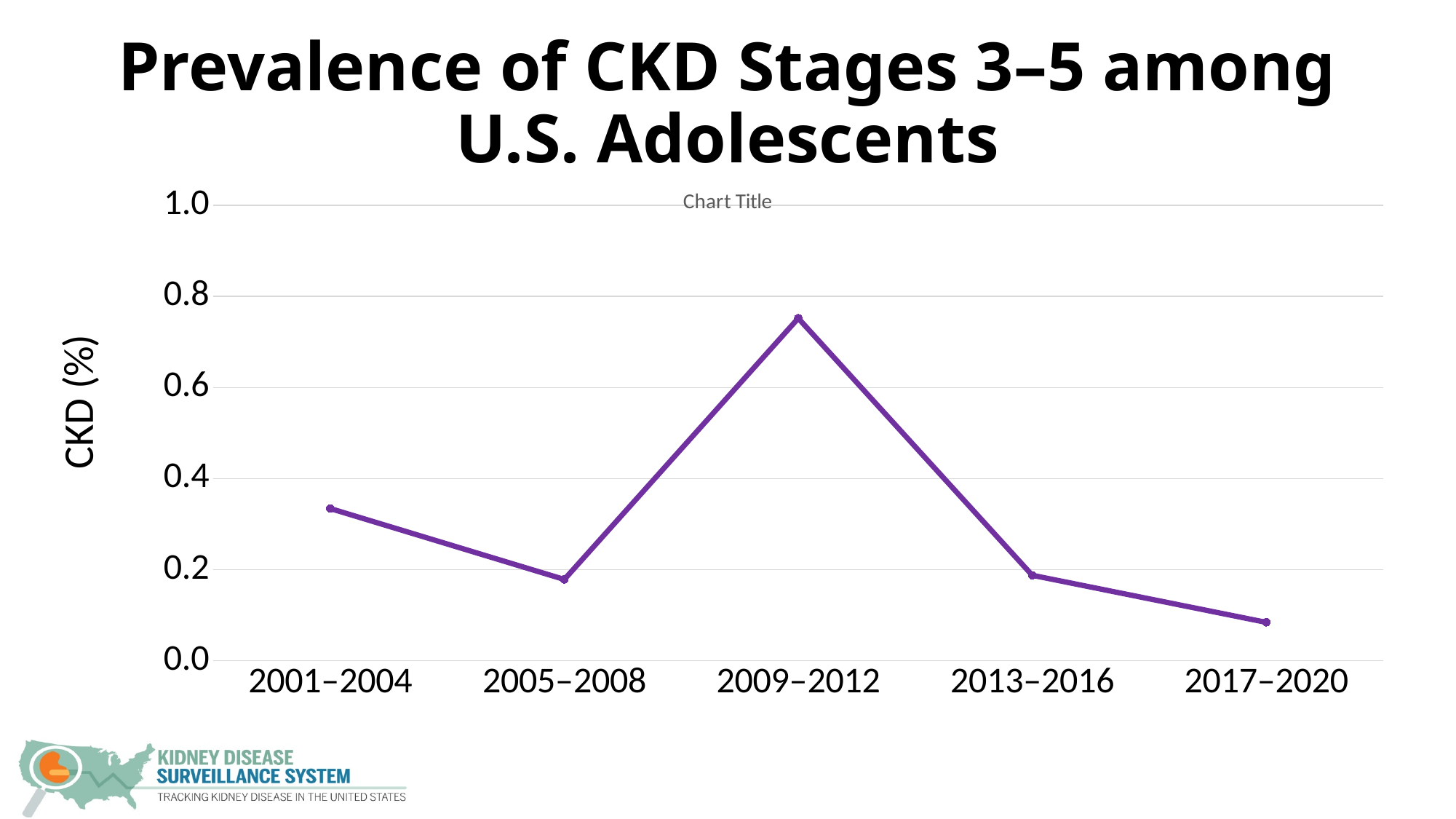
Is the value for 2017–2020 greater or less than 0.2? less How many time periods are plotted along the x axis? 5 Is the value for 2001–2004 greater or less than 0.2? greater Does the CKD prevalence rise or fall from 2009–2012 to 2017–2020? fall Which time period has the highest CKD prevalence? 2009–2012 Which has the higher CKD prevalence, 2001–2004 or 2005–2008? 2001–2004 Is the value for 2009–2012 greater or less than 0.6? greater What kind of chart is shown on the slide? line chart Which has the higher CKD prevalence, 2009–2012 or 2013–2016? 2009–2012 What is the label on the y axis? CKD (%) Which time period has the lowest CKD prevalence? 2017–2020